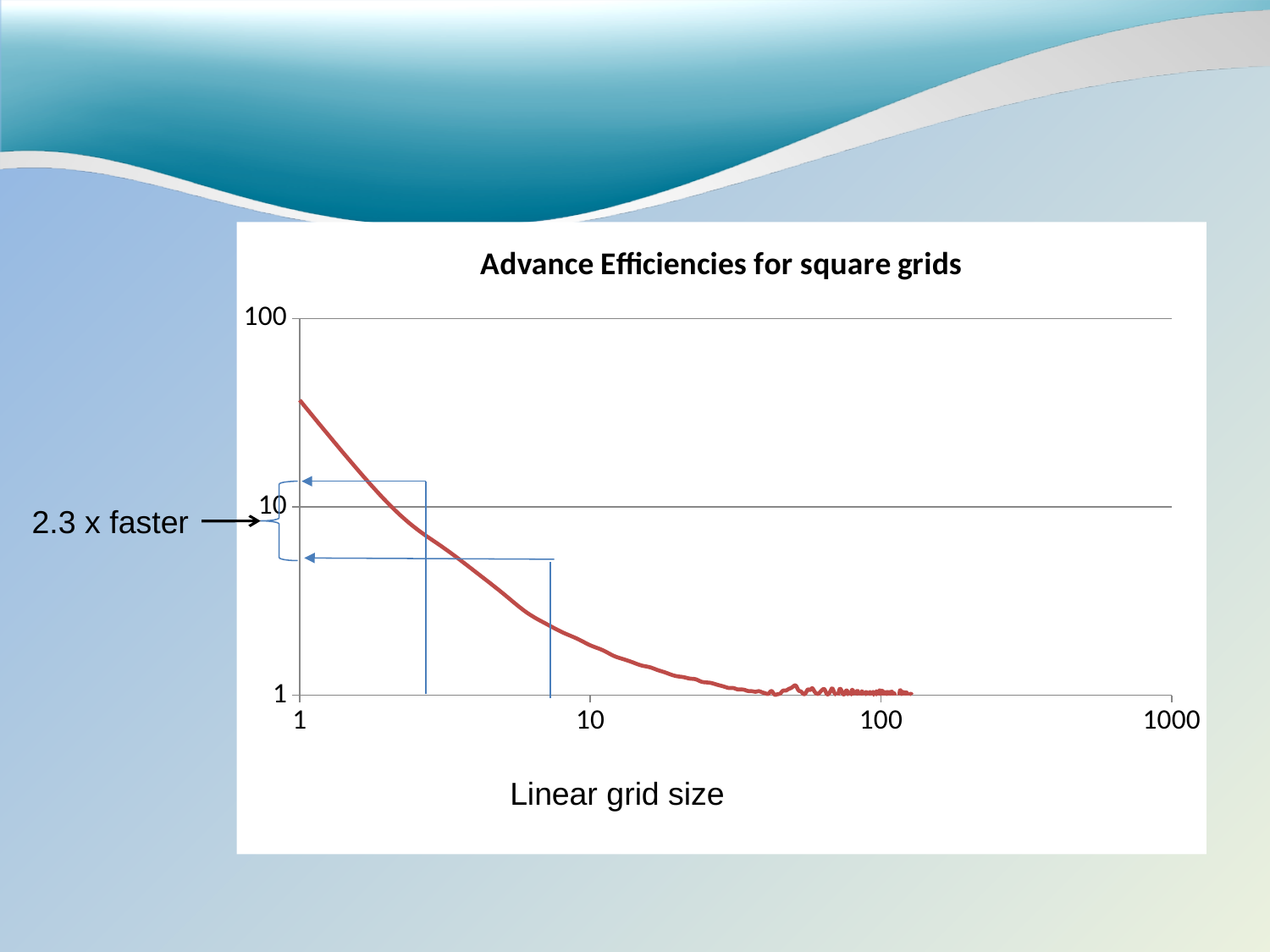
What is the highest tick value shown on the x axis? 1000 Is the value at a linear grid size of 100 greater or less than 10? less How many line series are plotted on the chart? 1 Do the plotted values rise or fall as the linear grid size increases? fall Is the value at a linear grid size of 10 greater or less than 10? less What is the label of the x axis? Linear grid size What kind of chart is shown on the slide? line chart Is the value at a linear grid size of 1 greater or less than 100? less What is the title of the chart? Advance Efficiencies for square grids Which linear grid size has the higher plotted value, 1 or 10? 1